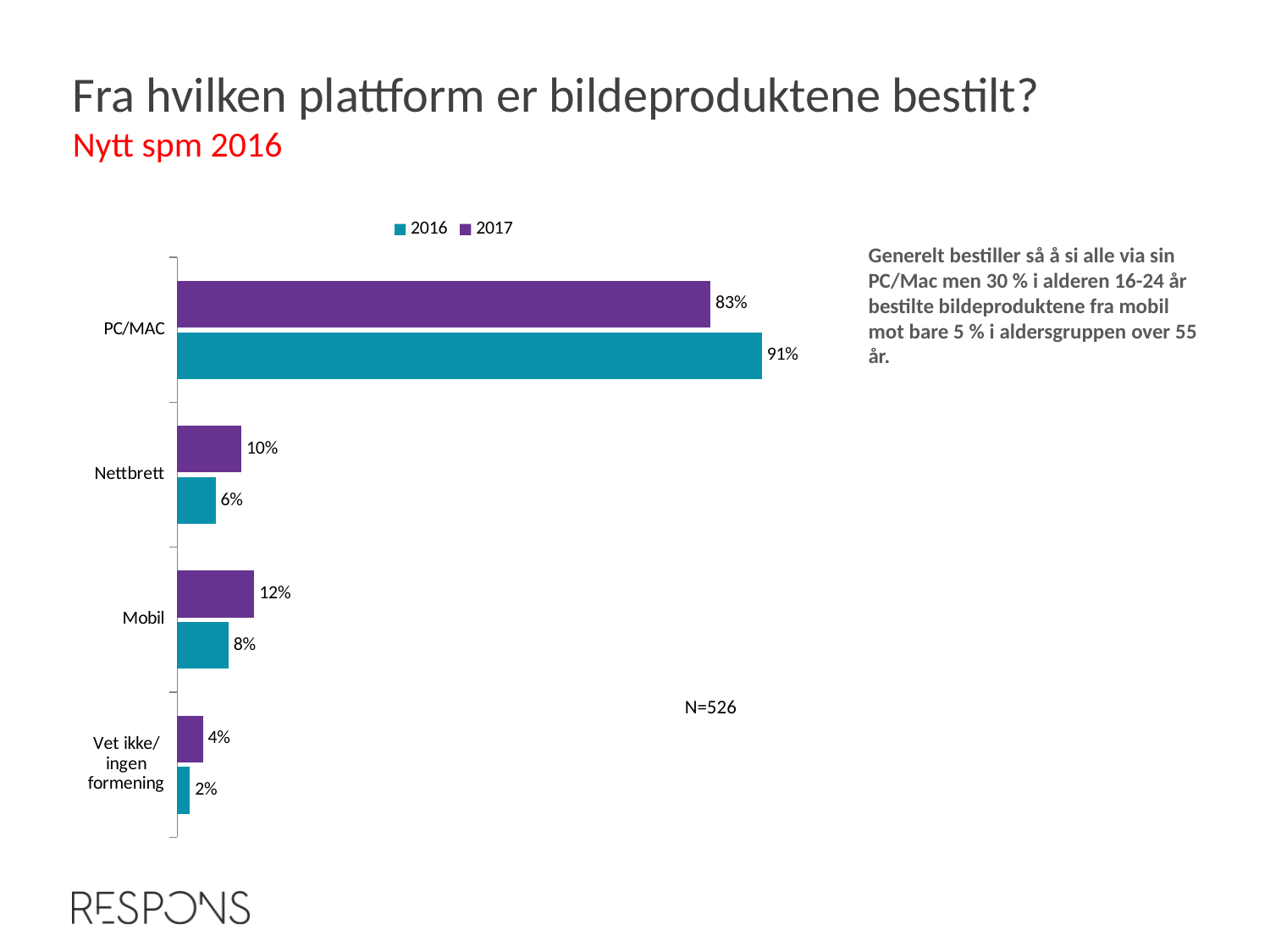
What is the difference between the 2016 and 2017 values for PC/MAC? 8% Which is larger for Mobil, the 2016 value or the 2017 value? 2017 Which category has the lowest 2017 value? Vet ikke/ingen formening How many series does the legend list? 2 How many categories are shown on the chart? 4 What is the 2017 value for Nettbrett? 10% What is the 2017 value for Vet ikke/ingen formening? 4% What is the 2017 value for PC/MAC? 83% What is the 2016 value for PC/MAC? 91% What is the 2016 value for Mobil? 8% What kind of chart is shown on the slide? Bar chart Which category has the highest 2016 value? PC/MAC